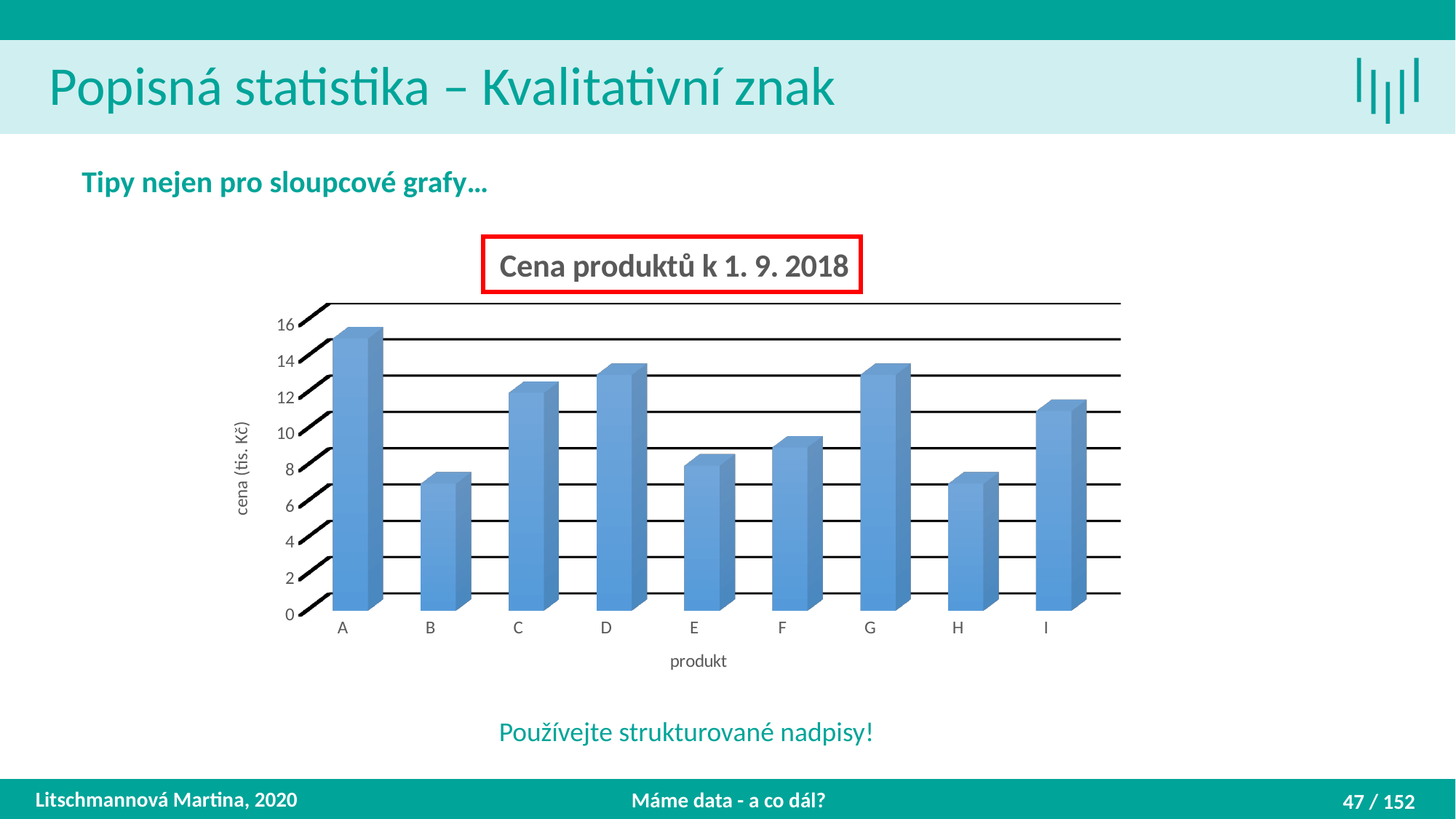
Is the value for product A greater or less than 14? greater Is the value for product C greater or less than 10? greater What is the label of the vertical axis of the chart? cena (tis. Kč) Is the value for product I greater or less than 10? greater What kind of chart is shown on the slide? bar chart Which has the larger value, product C or product E? C Which product has the highest price in the chart? A How many products (categories) are shown on the x axis of the chart? 9 Which has the larger value, product F or product I? I What is the title of the chart? Cena produktů k 1. 9. 2018